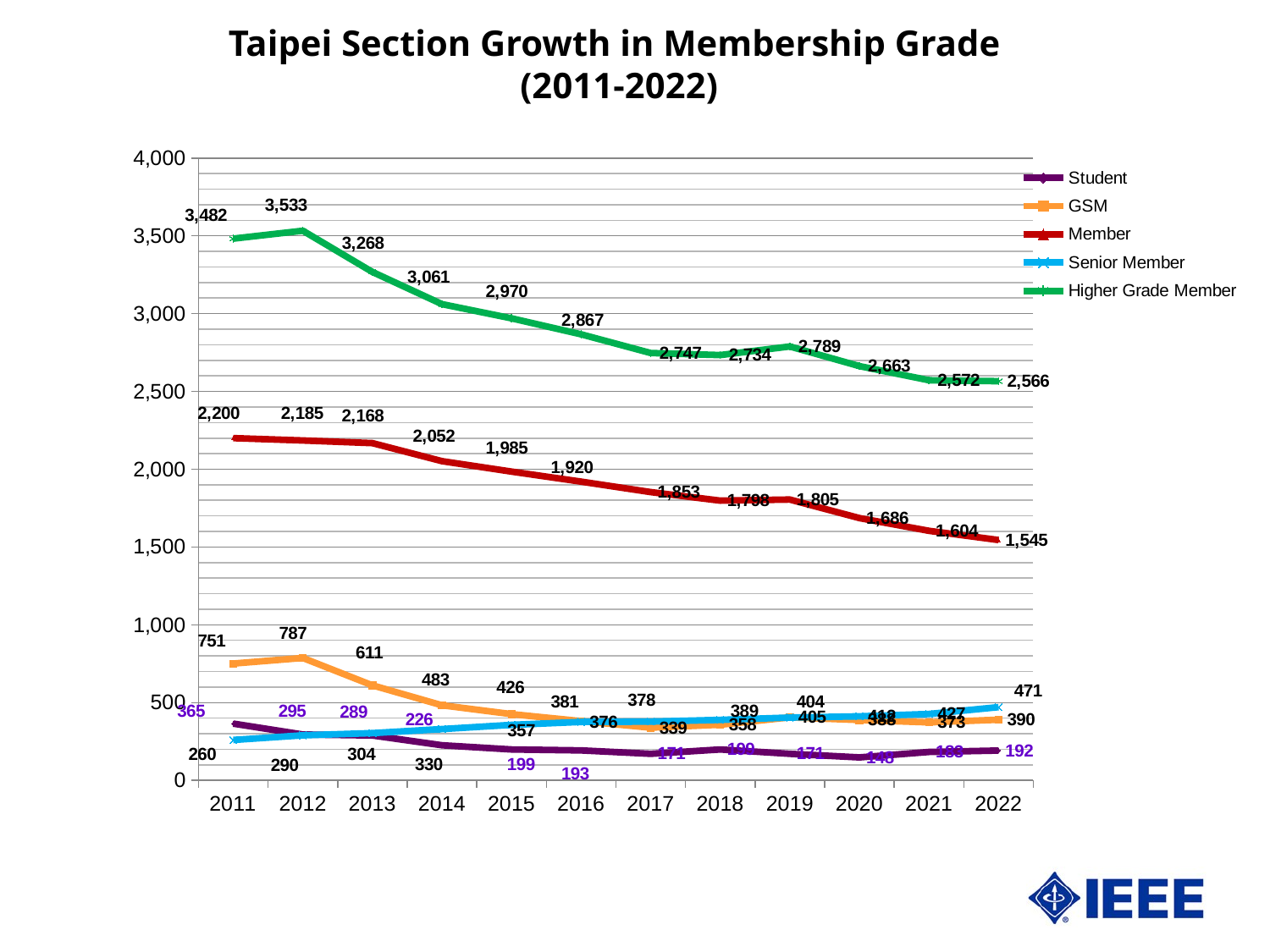
What kind of chart is shown on the slide? Line chart What is the Higher Grade Member value for 2012? 3,533 In which year is the Higher Grade Member value highest? 2012 What is the Senior Member value for 2022? 471 What is the GSM value for 2013? 611 In which year is the Higher Grade Member value lowest? 2022 Does the Member line rise or fall from 2011 to 2022? Fall By how much did the Member value fall from 2011 to 2022? 655 How many years are plotted along the x axis? 12 In 2011, which is larger: GSM or Senior Member? GSM How many series does the legend list? 5 What is the Member value for 2022? 1,545